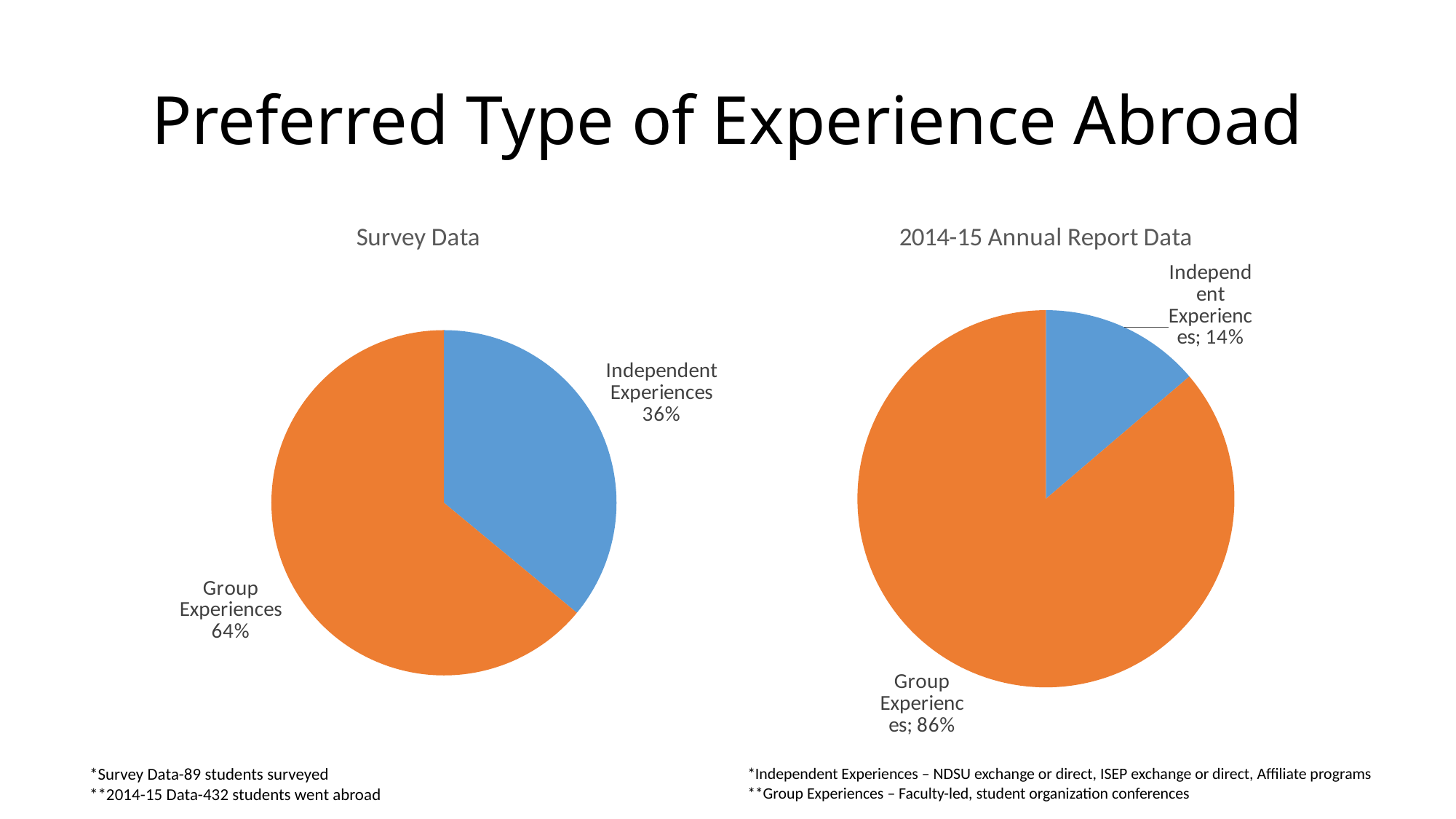
What kind of chart is the Survey Data chart? Pie chart In the 2014-15 Annual Report Data chart, what share of the pie is Group Experiences? 86% In the Survey Data chart, what share of the pie is Group Experiences? 64% What is the title of the chart on the right side of the slide? 2014-15 Annual Report Data In the Survey Data chart, which category has the largest slice? Group Experiences Which chart shows a larger share for Independent Experiences, Survey Data or 2014-15 Annual Report Data? Survey Data In the Survey Data chart, what share of the pie is Independent Experiences? 36% In the 2014-15 Annual Report Data chart, what is the difference in percentage points between Group Experiences and Independent Experiences? 72 In the Survey Data chart, what is the difference in percentage points between Group Experiences and Independent Experiences? 28 How many slices does the 2014-15 Annual Report Data pie chart have? 2 In the 2014-15 Annual Report Data chart, which category has the smallest slice? Independent Experiences